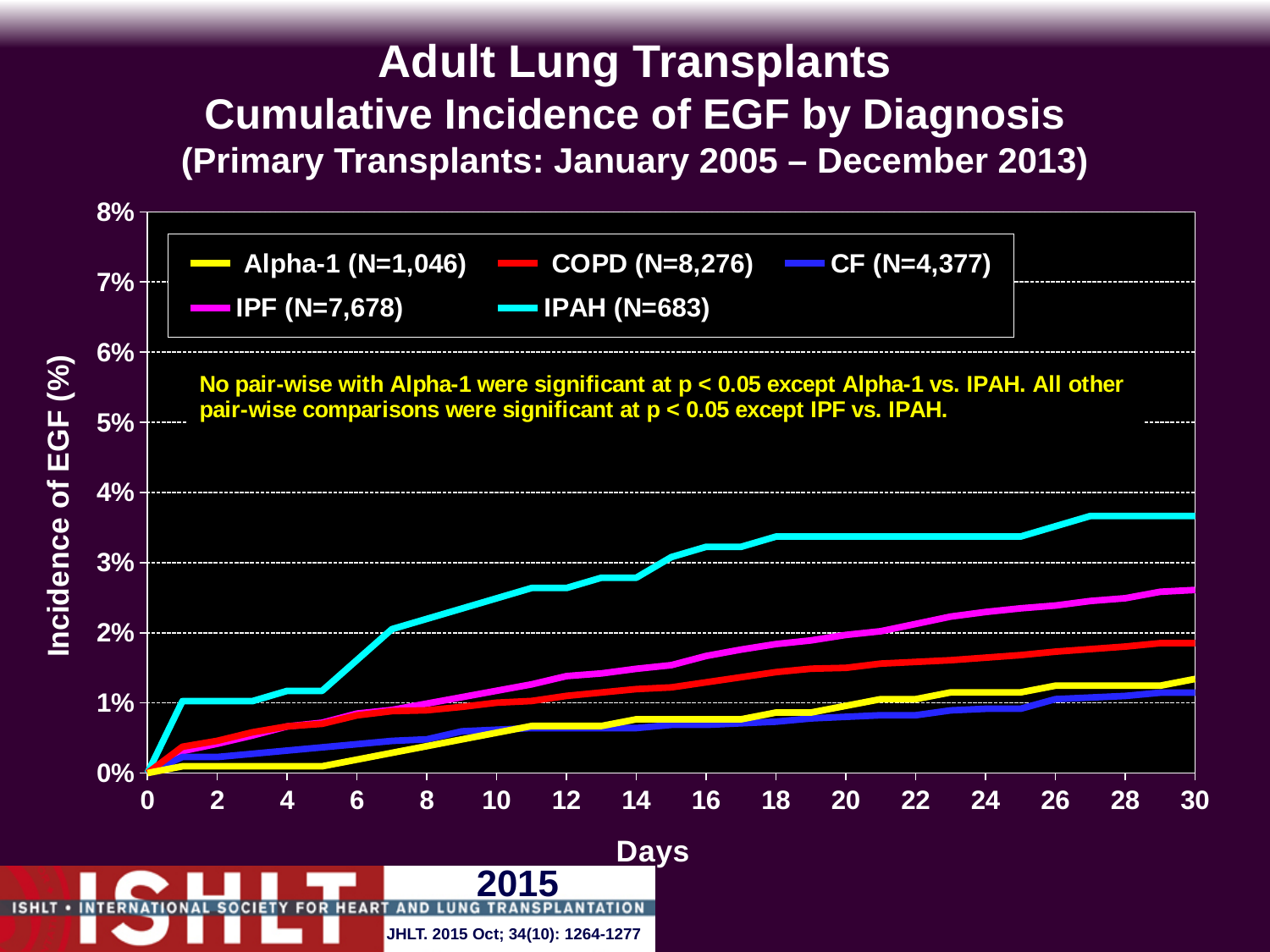
At day 30, which is larger, the value for IPAH or the value for COPD? IPAH Is the value for IPF at day 30 greater or less than 2%? greater Is the value for COPD at day 30 greater or less than 2%? less Do the cumulative incidence values rise or fall as the number of days increases? rise Which diagnosis group has the highest cumulative incidence of EGF at day 30? IPAH Is the value for Alpha-1 at day 10 greater or less than 1%? less How many series does the legend list? 5 What is the sample size (N) shown in the legend for COPD? 8,276 What kind of chart is shown on the slide? line chart What is the label of the x axis? Days